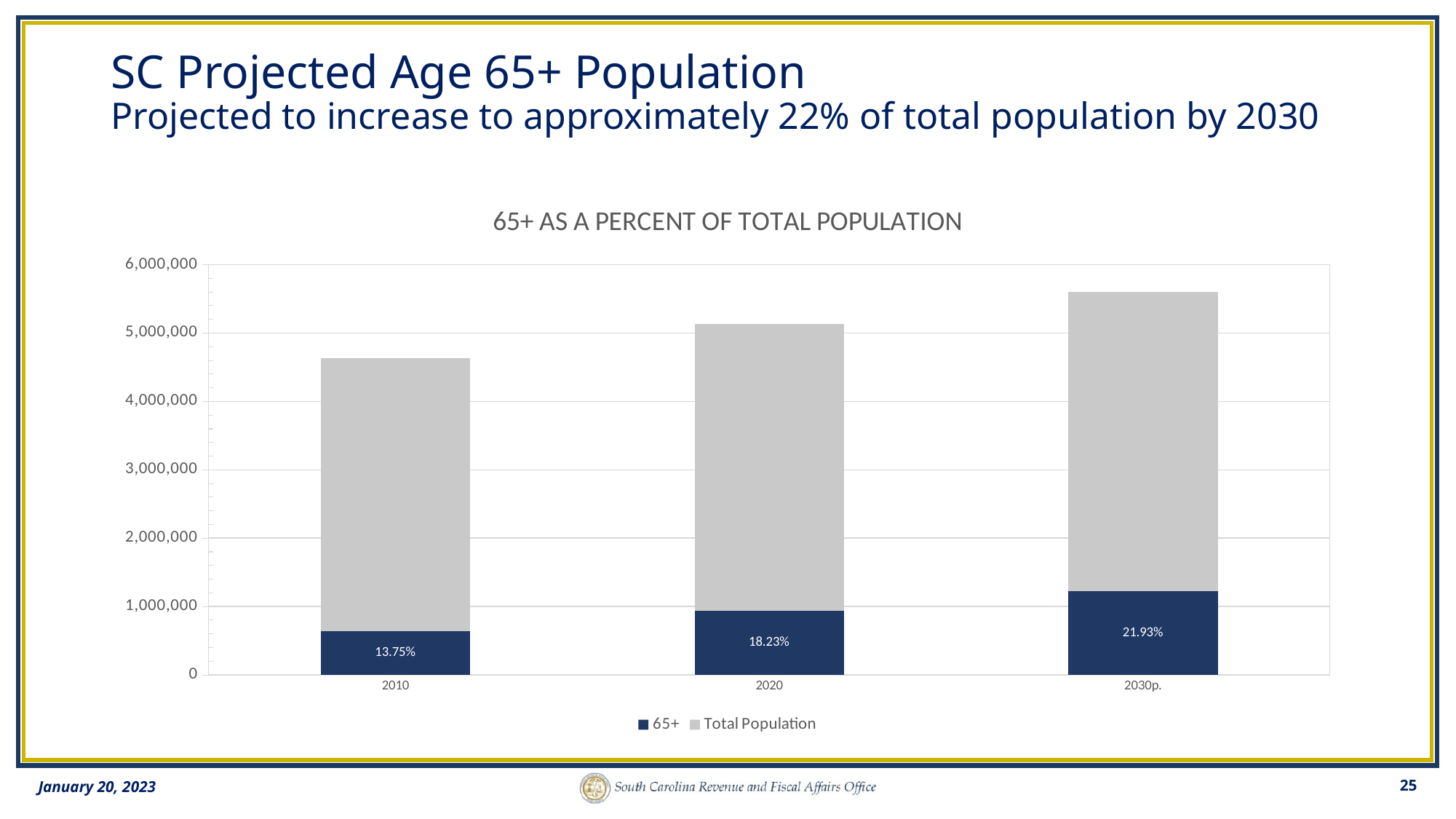
Does the 65+ percentage rise or fall from 2010 to 2030p.? rise What percentage label is shown on the 65+ segment for 2020? 18.23% By how many percentage points does the 65+ share label for 2030p. exceed the label for 2010? 8.18 percentage points How many series does the legend list? 2 What percentage label is shown on the 65+ segment for 2030p.? 21.93% What percentage label is shown on the 65+ segment for 2010? 13.75% Which year has the highest 65+ percentage label? 2030p. Is the total height of the 2010 bar greater or less than 5,000,000? less How many years are shown on the x axis? 3 Is the 65+ segment for 2030p. greater or less than 1,000,000? greater Is the total height of the 2030p. bar greater or less than 5,000,000? greater Which year has the lowest 65+ percentage label? 2010